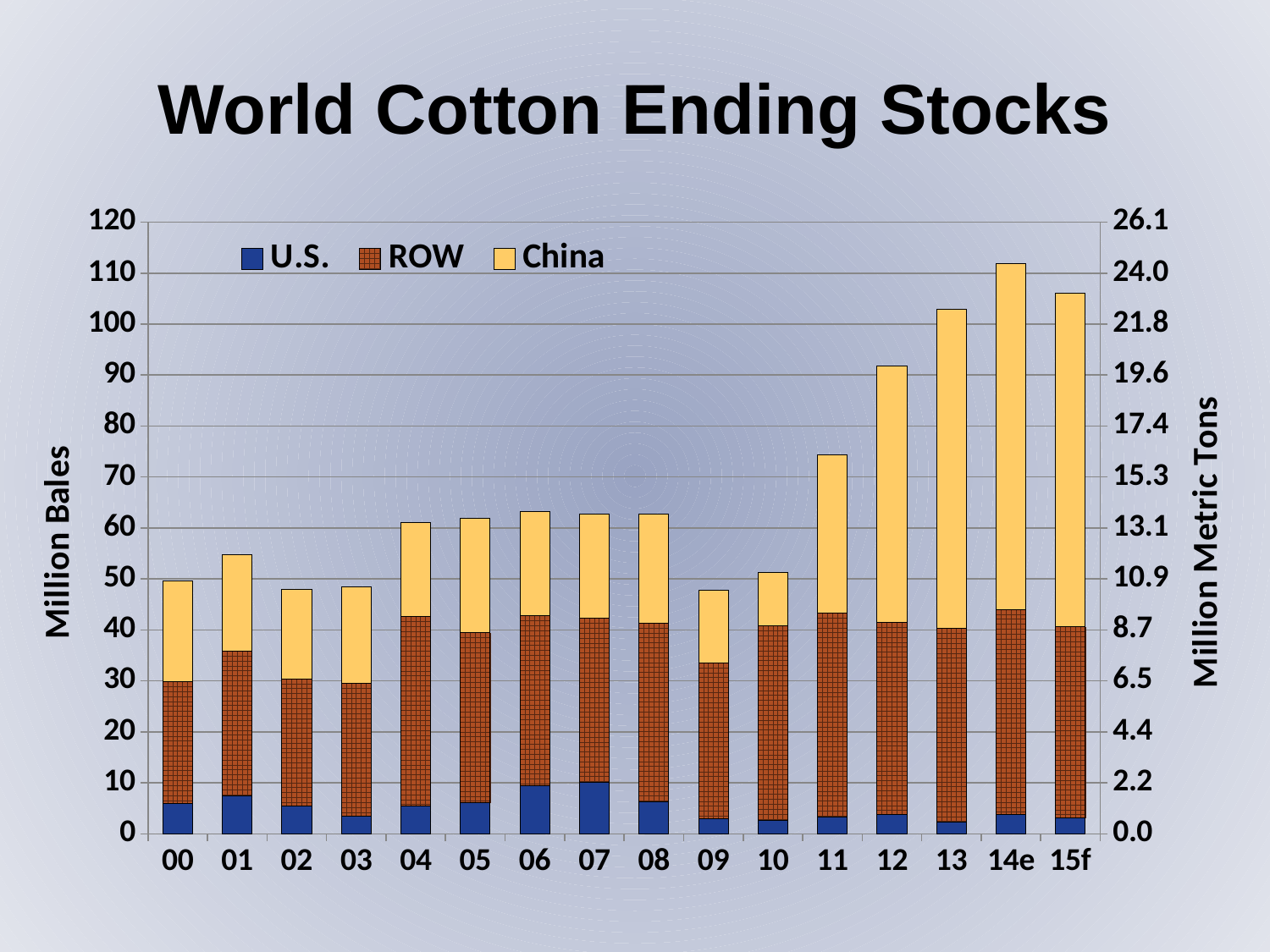
What is the title of the chart? World Cotton Ending Stocks Which has the larger total ending stocks, 14e or 15f? 14e Which has the larger total ending stocks, 11 or 12? 12 Is the total for 11 greater or less than 70 million bales? greater Do total ending stocks rise or fall from 11 to 14e? rise How many series does the legend list? 3 Which year has the highest total ending stocks? 14e Is the total for 01 greater or less than 50 million bales? greater What is the label of the left vertical axis? Million Bales Is the total for 15f greater or less than 100 million bales? greater What kind of chart is shown on the slide? Stacked bar chart How many years (categories) are shown on the x axis? 16